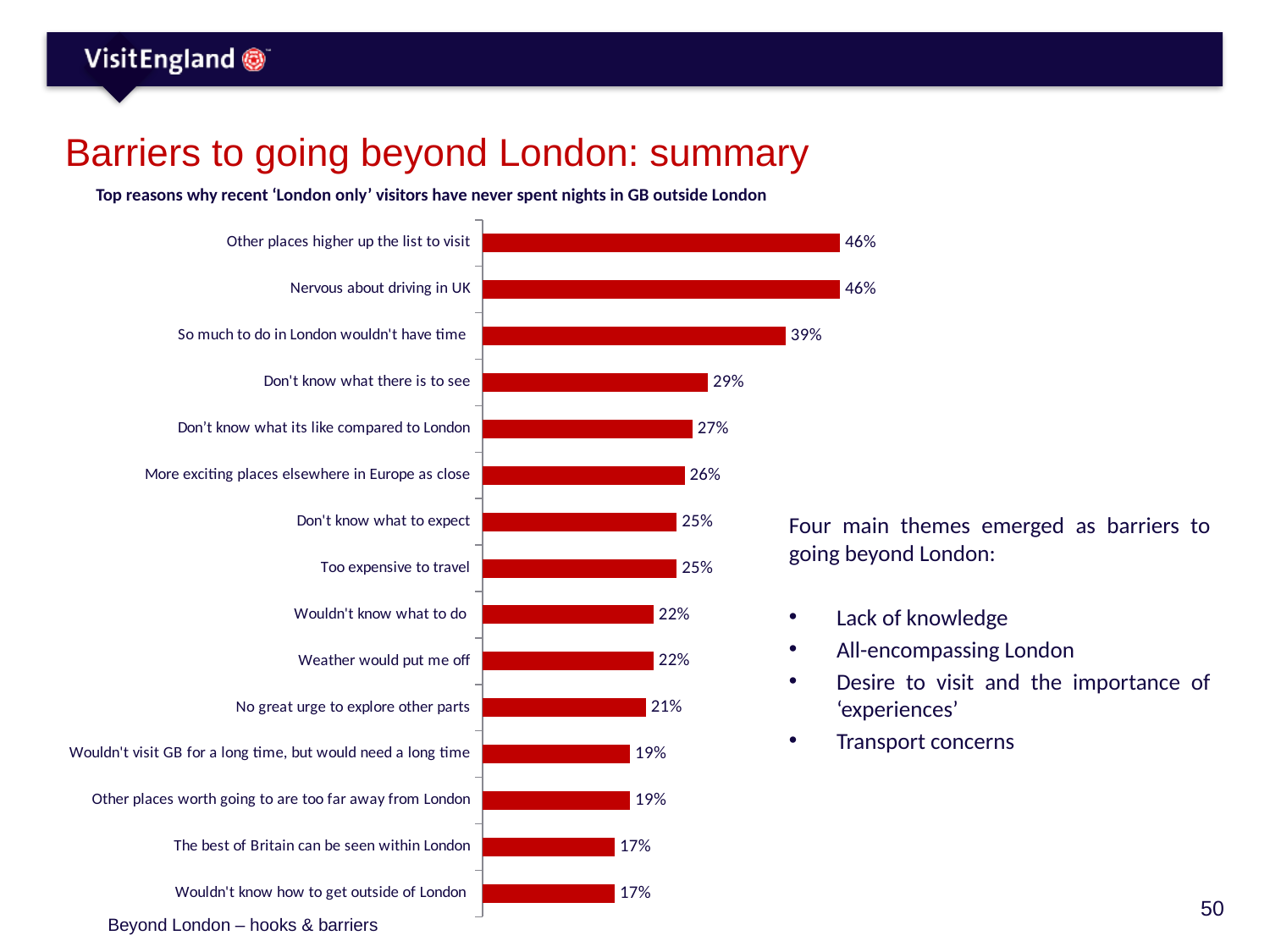
What is the value for 'Weather would put me off'? 22% How many reasons (categories) are plotted on the chart? 15 What percentage of recent 'London only' visitors cited 'Nervous about driving in UK' as a reason for never spending nights in GB outside London? 46% What type of chart is used to show the top reasons for never spending nights outside London? Bar chart What is the value for 'Wouldn't know how to get outside of London'? 17% Which reason has the lowest value shown on the chart, 'The best of Britain can be seen within London' or 'Don't know what there is to see'? The best of Britain can be seen within London Do the values rise or fall as you read the bars from top to bottom? Fall What is the difference between 'So much to do in London wouldn't have time' and 'Too expensive to travel'? 14% What is the difference between the value for 'Other places higher up the list to visit' and the value for 'Don't know what there is to see'? 17% What is the value for 'So much to do in London wouldn't have time'? 39% What is the title of the chart? Top reasons why recent 'London only' visitors have never spent nights in GB outside London Which is larger: the value for 'More exciting places elsewhere in Europe as close' or the value for 'No great urge to explore other parts'? More exciting places elsewhere in Europe as close